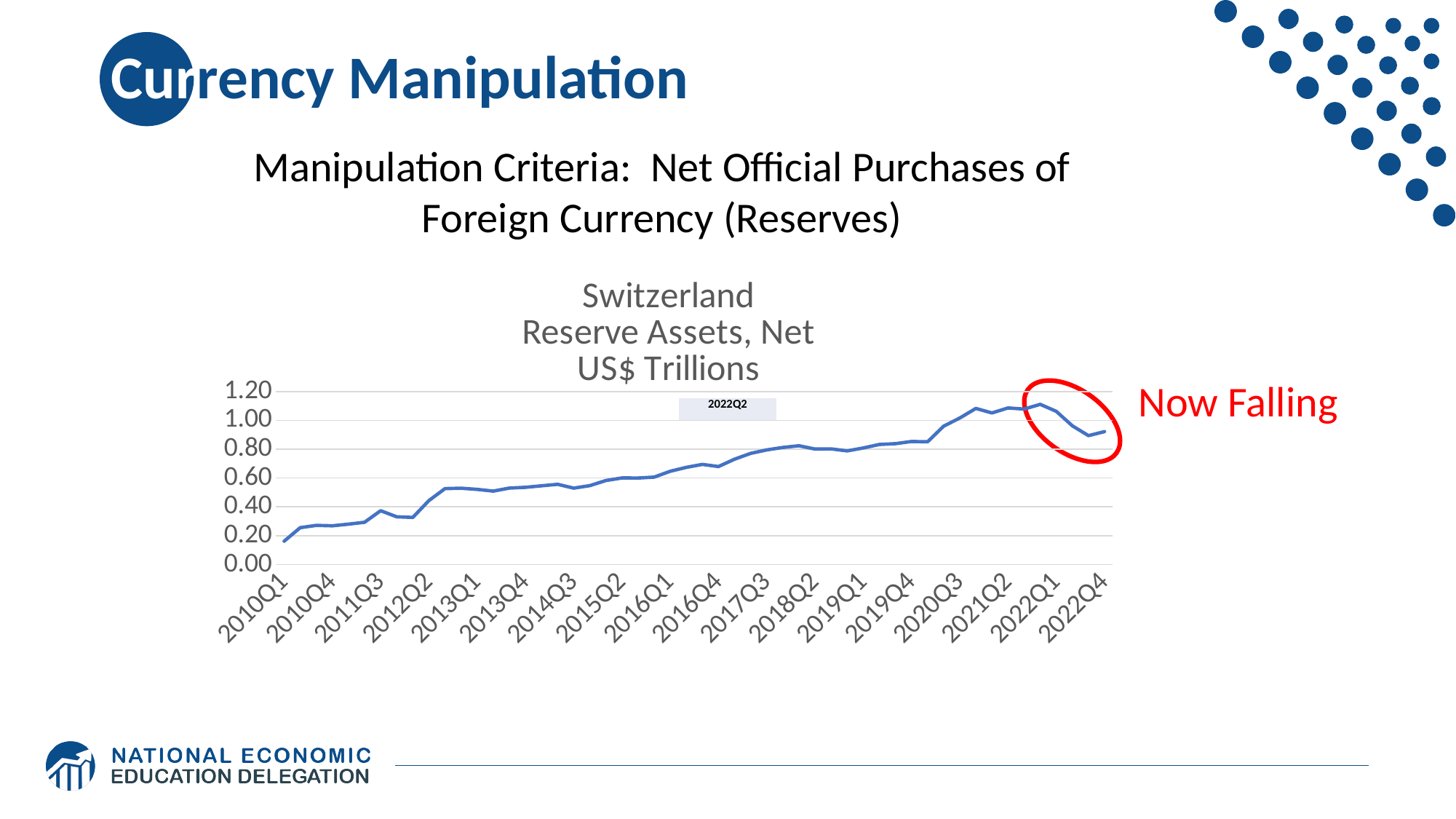
Do the values rise or fall over the last few quarters of the series, from 2022Q1 to 2022Q4? fall Is the value for 2021Q2 greater or less than 1.00? greater What is the title of the chart? Switzerland Reserve Assets, Net US$ Trillions Which quarter has the lowest value on the chart? 2010Q1 Is the value for 2010Q4 greater or less than 0.40? less Is the value for 2022Q4 greater or less than 1.00? less What does the red annotation next to the circled part of the line say? Now Falling Which is larger, the value for 2010Q1 or the value for 2022Q4? 2022Q4 Which is larger, the value for 2016Q1 or the value for 2019Q1? 2019Q1 What kind of chart is shown on the slide? line chart Overall, do Switzerland's net reserve assets rise or fall from 2010Q1 to 2021Q2? rise